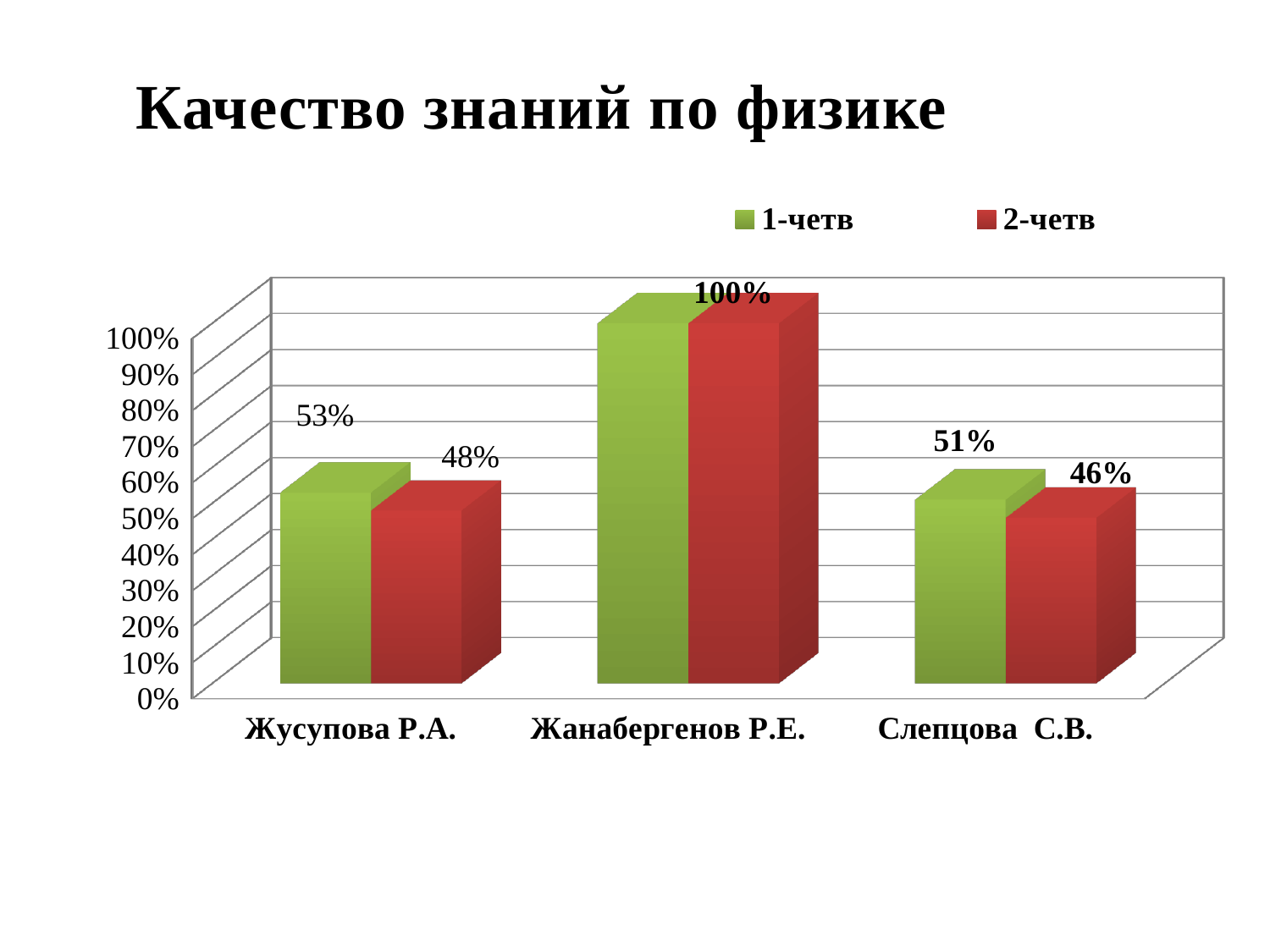
What is the value for Слепцова С.В. in the 1-четв series? 51% What is the value for Слепцова С.В. in the 2-четв series? 46% How many teachers (categories) are shown on the x axis? 3 What is the value for Жусупова Р.А. in the 2-четв series? 48% Which teacher has the lowest value in the 2-четв series? Слепцова С.В. What is the difference between the 1-четв and 2-четв values for Жусупова Р.А.? 5% Is the 2-четв value for Жанабергенов Р.Е. greater or less than 90%? greater How many series does the legend list? 2 What is the value for Жусупова Р.А. in the 1-четв series? 53% What kind of chart is shown on the slide? bar chart Which is larger: the 1-четв value for Жусупова Р.А. or the 1-четв value for Слепцова С.В.? Жусупова Р.А. Which teacher has the highest value in the 1-четв series? Жанабергенов Р.Е.